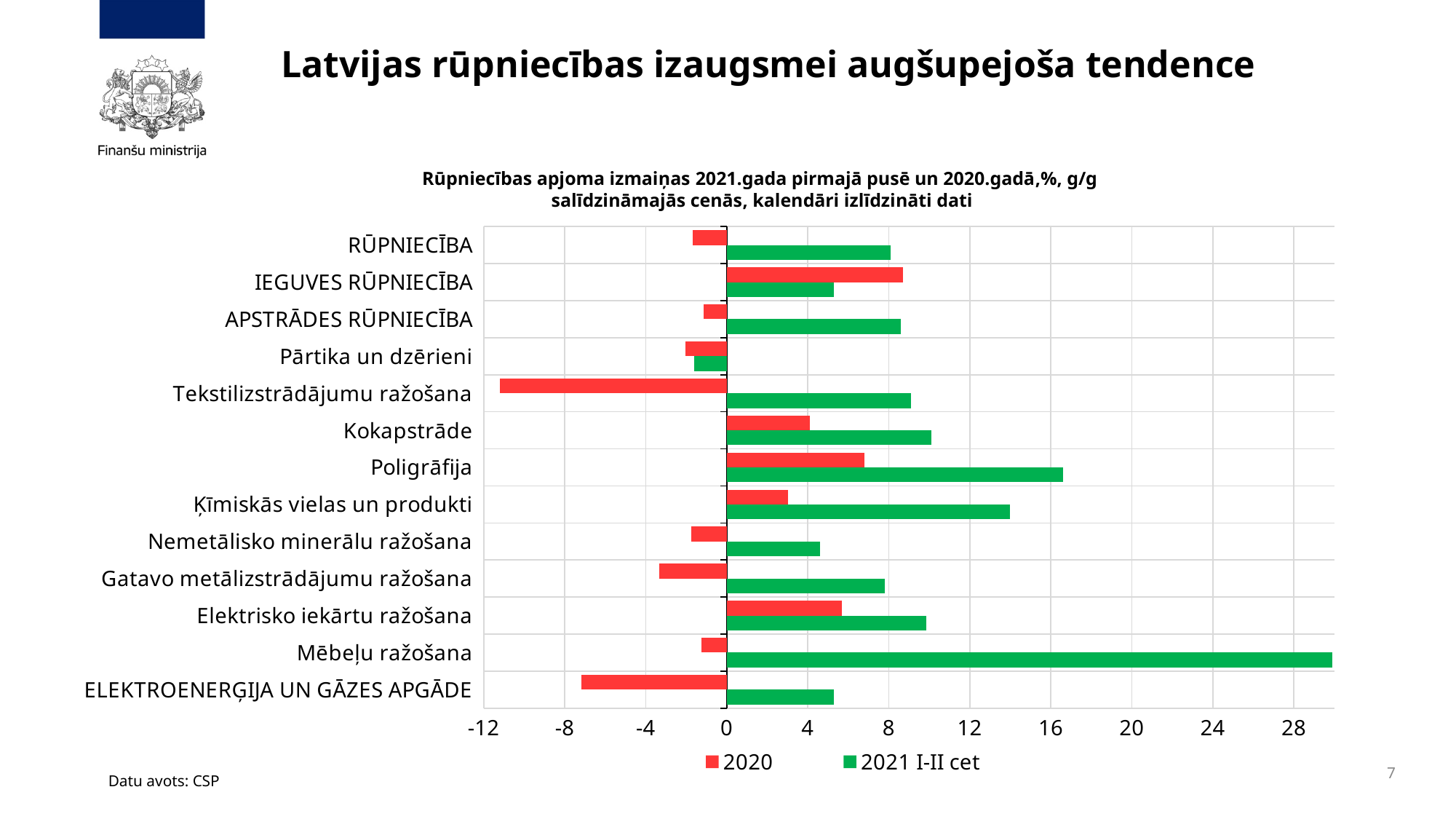
How many categories are shown on the vertical axis of the chart? 13 Is the 2020 value for Tekstilizstrādājumu ražošana greater or less than -8? less How many series does the legend list? 2 Which category has the highest value for the 2020 series? IEGUVES RŪPNIECĪBA Which colour represents the 2020 series in the chart? Red Is the 2021 I-II cet value for Poligrāfija greater or less than 16? greater Is the 2021 I-II cet value for Mēbeļu ražošana greater or less than 28? greater For IEGUVES RŪPNIECĪBA, which series has the larger value: 2020 or 2021 I-II cet? 2020 Which category has the highest value for the 2021 I-II cet series? Mēbeļu ražošana What kind of chart is shown on the slide? Bar chart Which category has the lowest value for the 2020 series? Tekstilizstrādājumu ražošana For Kokapstrāde, which series has the larger value: 2020 or 2021 I-II cet? 2021 I-II cet